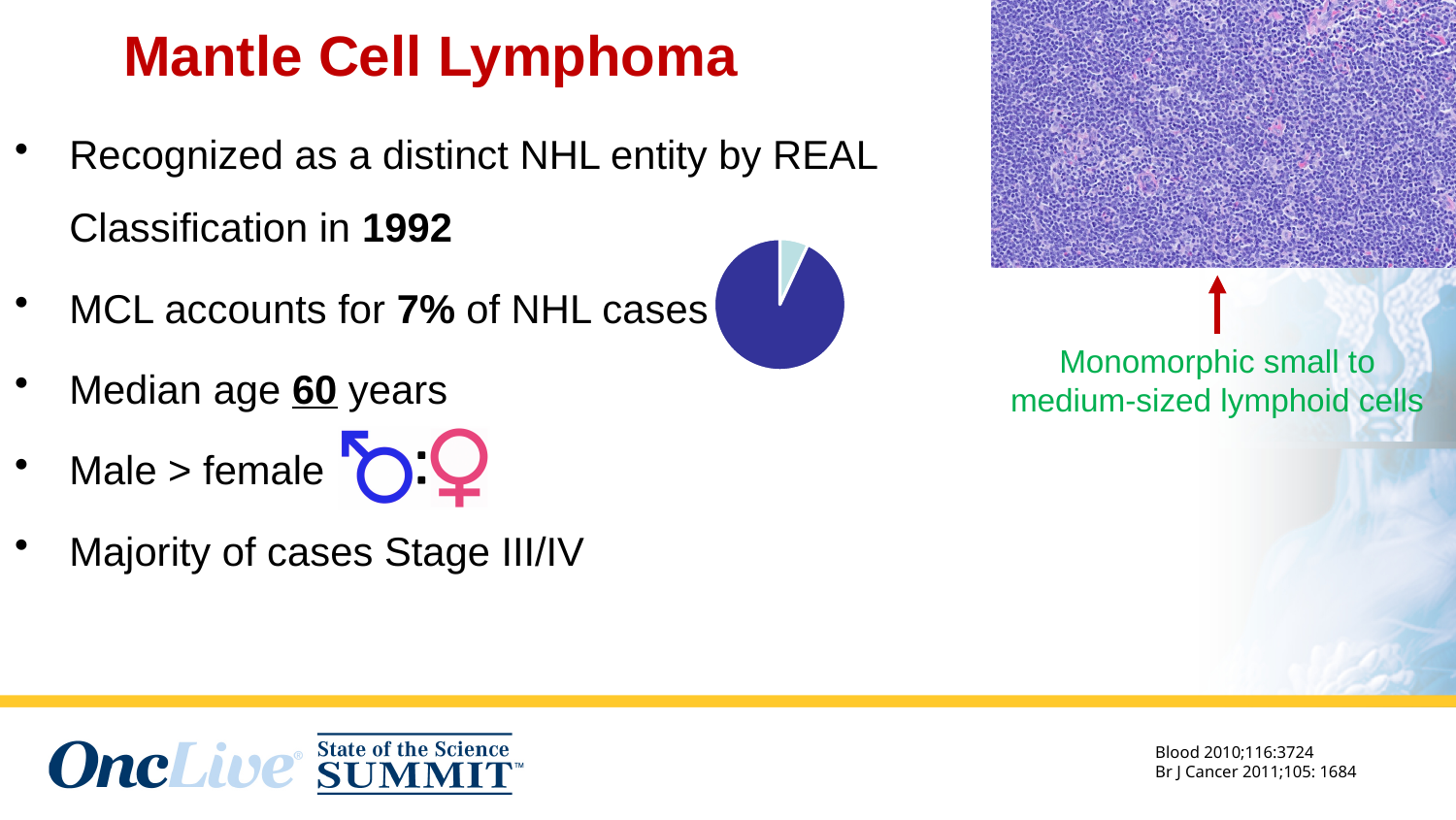
What kind of chart is shown next to the bullet points on the slide? Pie chart Which slice of the pie chart is larger, the dark blue slice or the light blue slice? The dark blue slice Is the light blue slice's share of the pie greater or less than 50%? less How many slices does the pie chart have? 2 Does the pie chart display a legend? No According to the slide text, what share of NHL cases does the small light blue slice of the pie represent (MCL)? 7% Which slice of the pie chart is the smallest? The light blue slice What colour is the largest slice of the pie chart? Dark blue